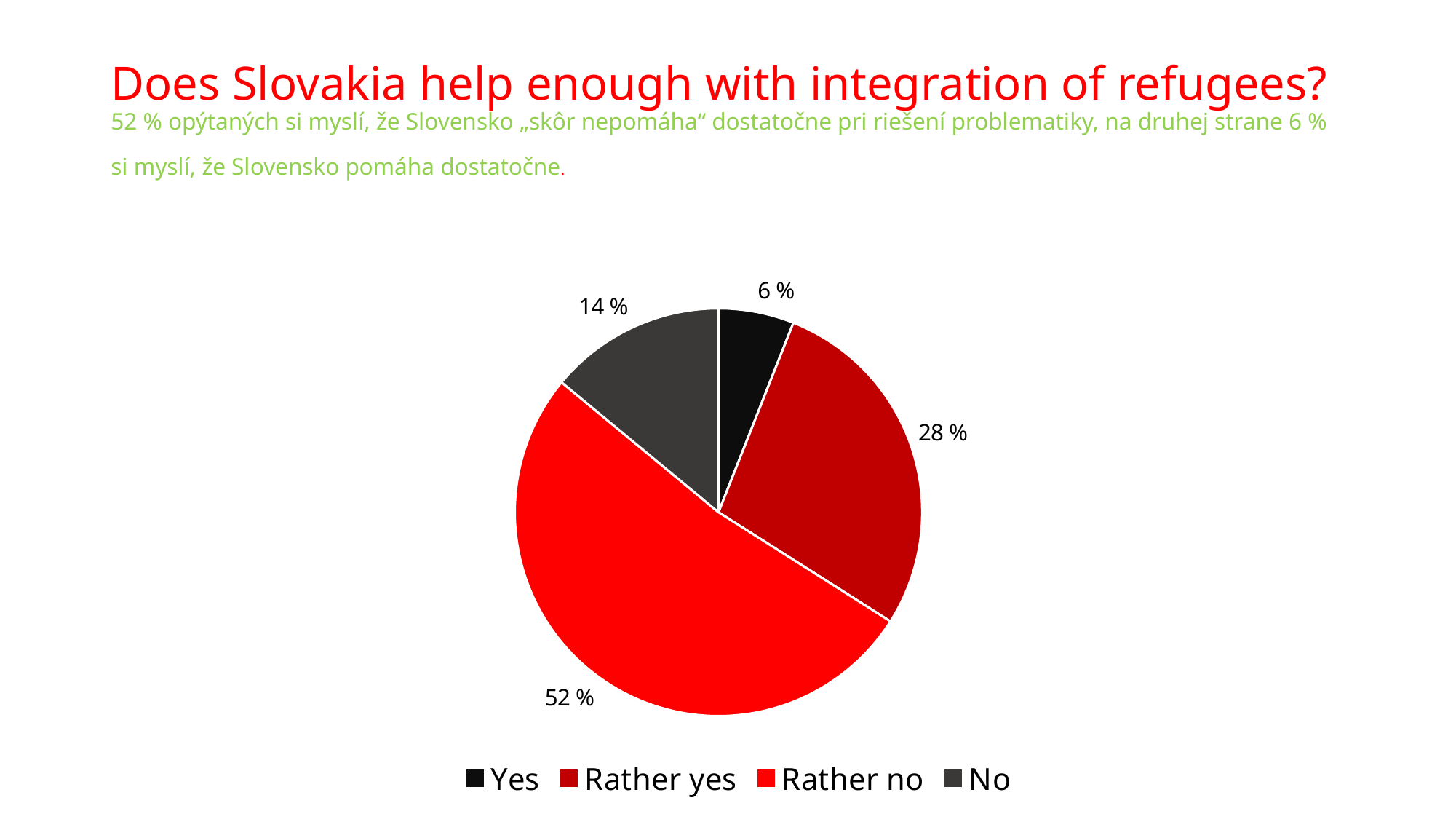
How many slices does the pie chart have? 4 What share of respondents answered "Rather yes"? 28 % What is the difference between the "Rather no" and "Rather yes" shares? 24 % What kind of chart is shown on the slide? Pie chart What share of respondents answered "Rather no"? 52 % What is the title of the slide containing the chart? Does Slovakia help enough with integration of refugees? Which is larger, the share for "No" or the share for "Rather yes"? Rather yes What share of respondents answered "No"? 14 % What share of respondents answered "Yes"? 6 % Which answer has the largest slice of the pie? Rather no Which answer has the smallest slice of the pie? Yes How many entries does the legend list? 4